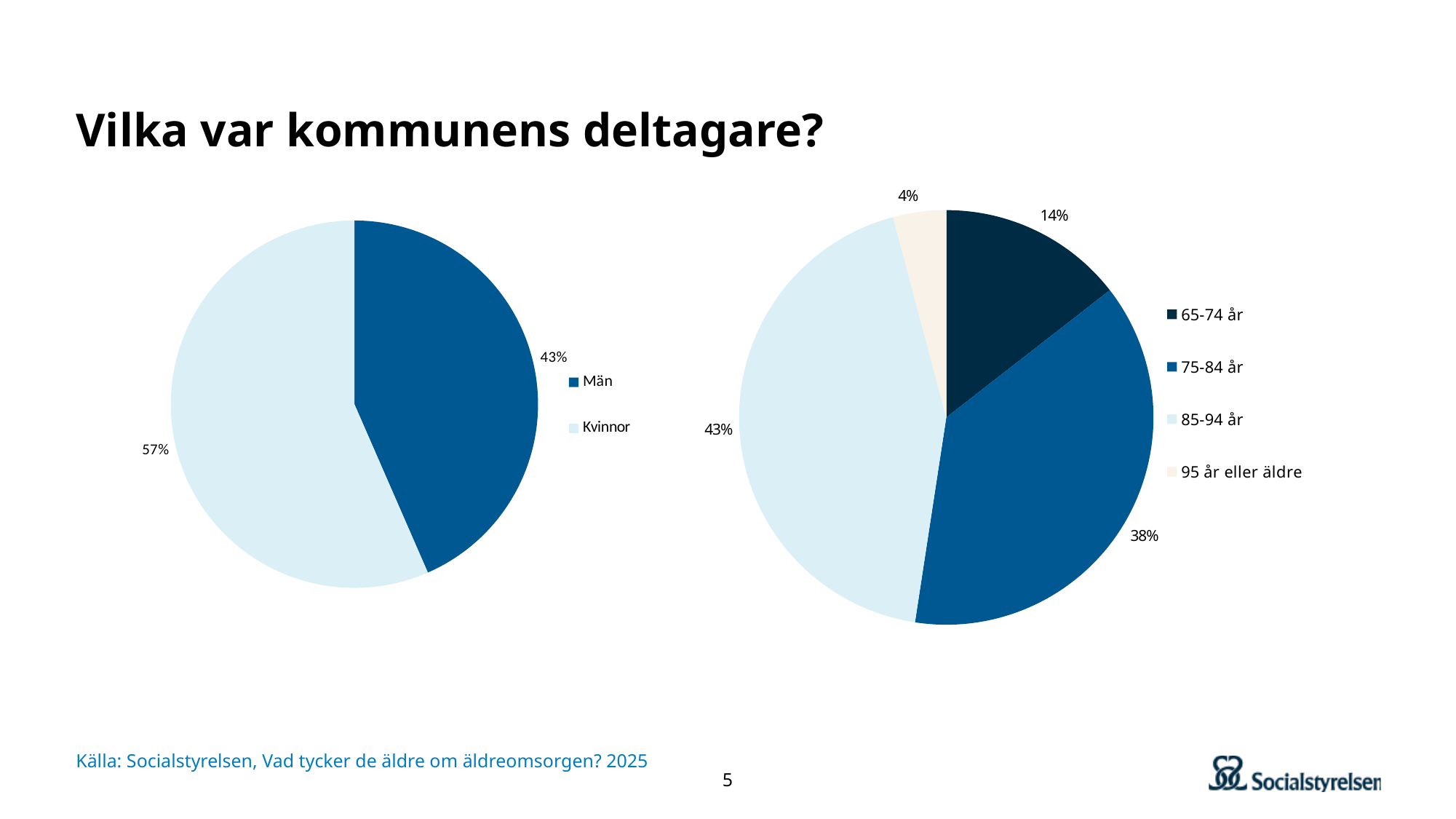
In the left pie chart, what is the difference in percentage points between Kvinnor and Män? 14 In the left pie chart, which group has the larger share, Män or Kvinnor? Kvinnor In the right pie chart, which age group has the largest share? 85-94 år In the right pie chart, which age group has the smallest share? 95 år eller äldre In the right pie chart, how many age groups does the legend list? 4 In the right pie chart, what share of participants are 95 år eller äldre? 4% What type of chart is used on the right side of the slide? Pie chart In the right pie chart, what share of participants are 75-84 år? 38% In the left pie chart, what share of participants are Män? 43% In the right pie chart, what share of participants are 65-74 år? 14% In the left pie chart, how many slices are there? 2 In the left pie chart, what share of participants are Kvinnor? 57%